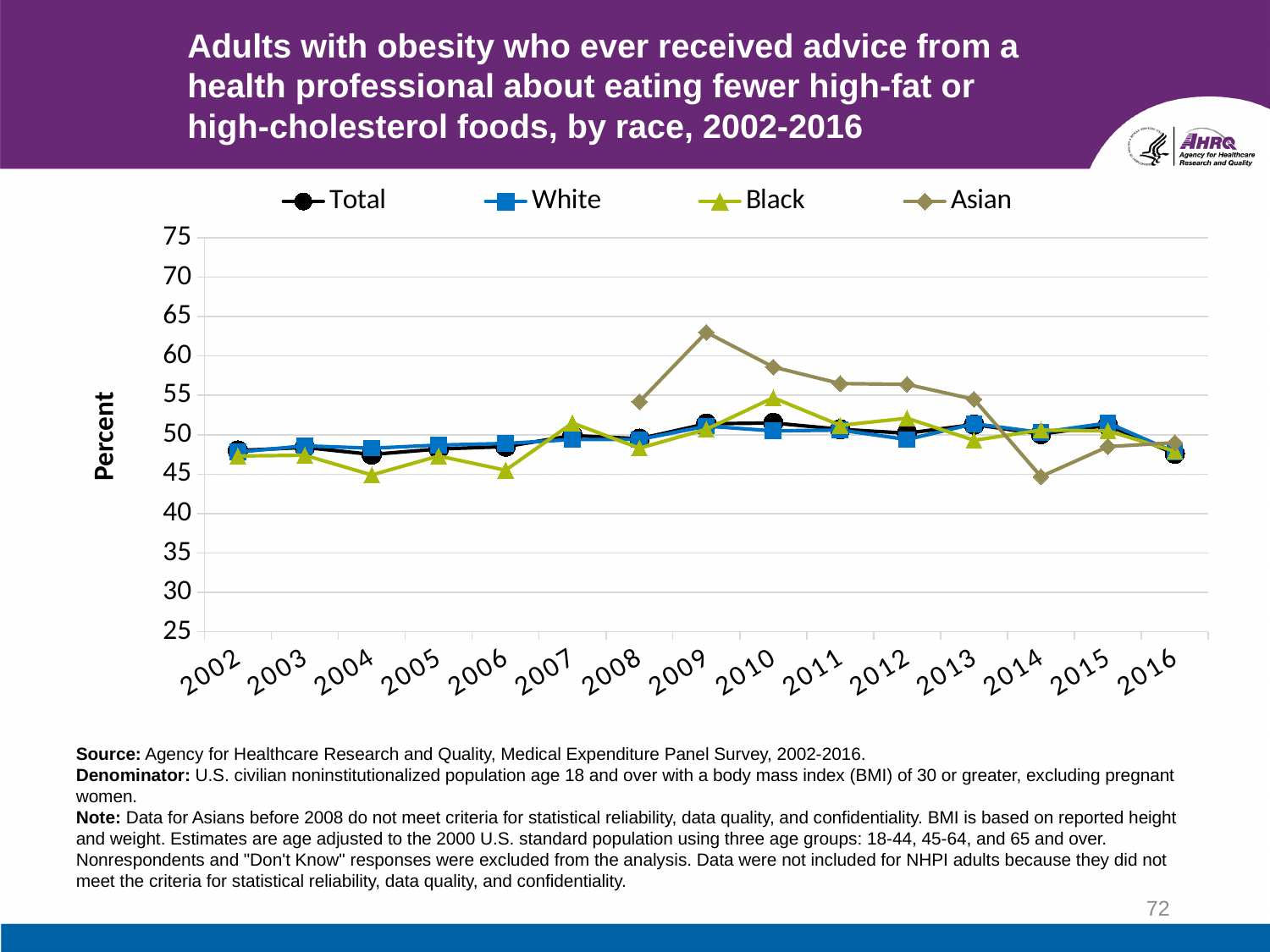
In 2004, which is larger, the value for White or the value for Black? White Is the value for Asian in 2009 greater or less than 60? greater How many years are shown along the x axis? 15 Is the value for Asian in 2014 greater or less than 50? less Is the value for Black in 2004 greater or less than 50? less What kind of chart is shown on the slide? Line chart In which year does the Asian series reach its highest value? 2009 Does the Asian series rise or fall from 2009 to 2014? Fall How many series does the legend list? 4 Which series has the highest value in 2009? Asian In which year does the Asian series reach its lowest value? 2014